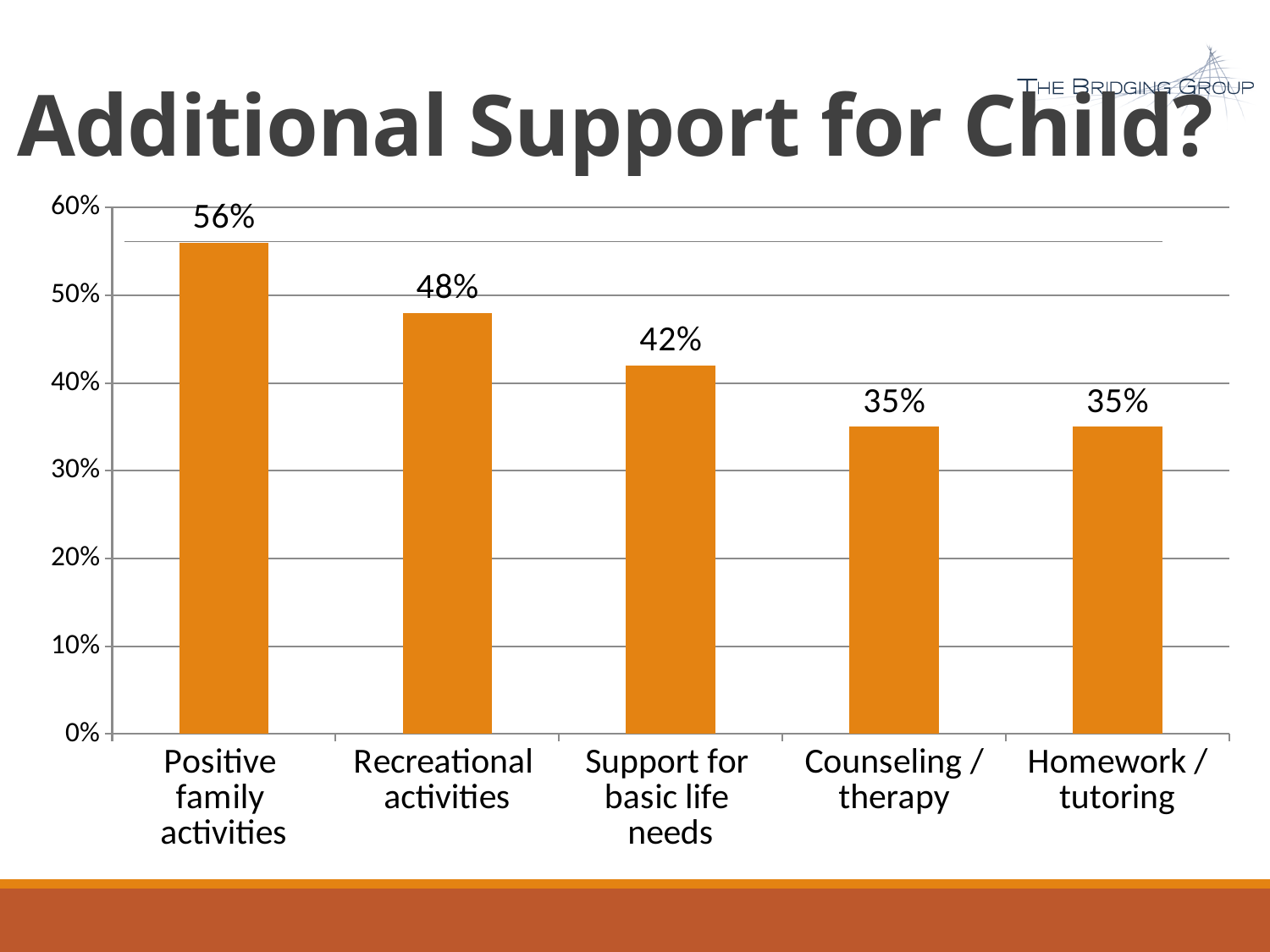
What kind of chart is shown on the slide? Bar chart What is the difference between Recreational activities and Support for basic life needs? 6% What is the value for Support for basic life needs? 42% What is the value for Positive family activities? 56% Which is larger, Recreational activities or Homework / tutoring? Recreational activities Is the value for Support for basic life needs greater or less than 40%? greater Which category has the highest value? Positive family activities What is the value for Recreational activities? 48% What is the value for Counseling / therapy? 35% What is the difference between Positive family activities and Recreational activities? 8% How many categories are shown in the chart? 5 What is the title of the slide? Additional Support for Child?